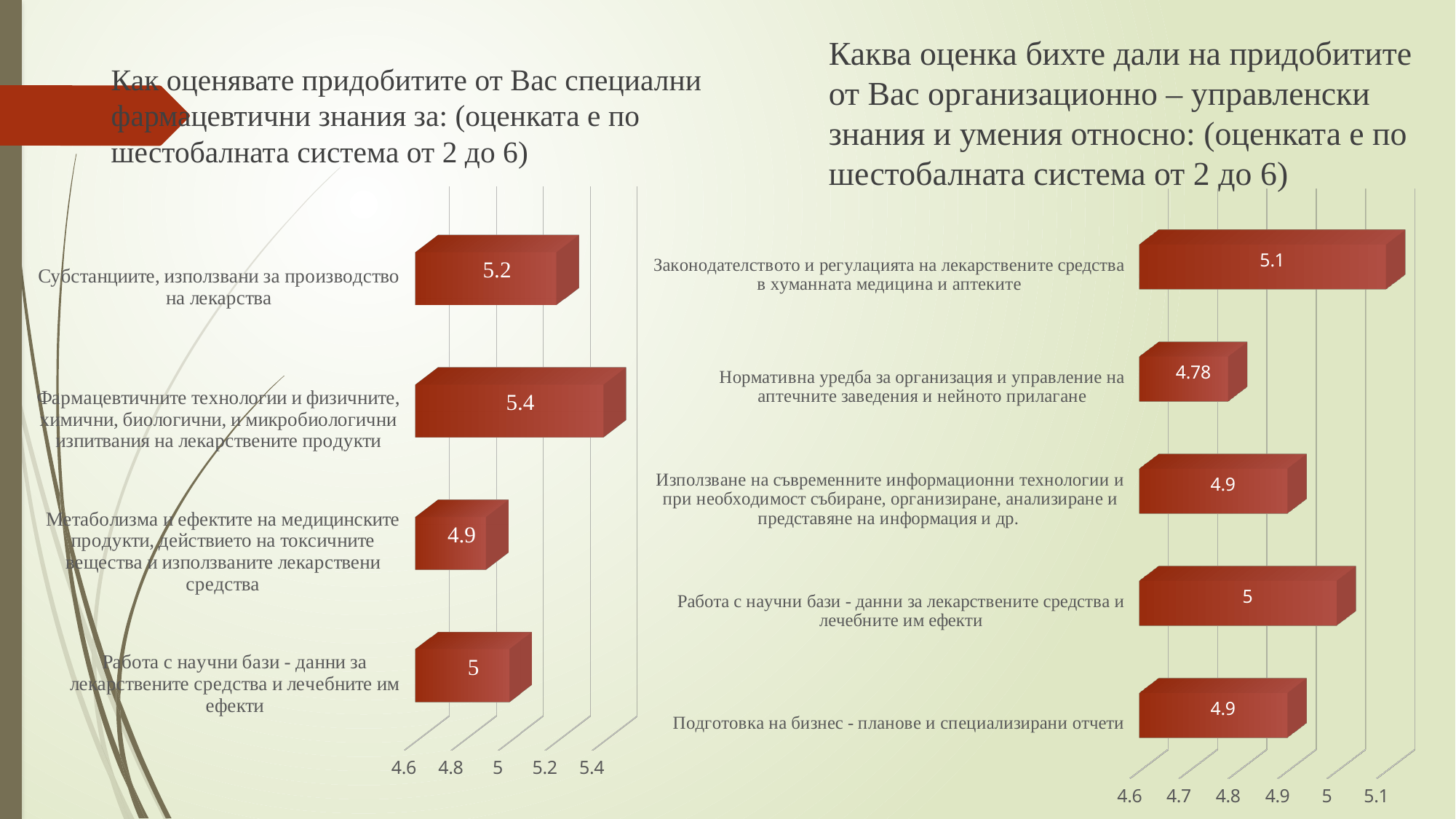
On the right chart, which category has the lowest value? Нормативна уредба за организация и управление на аптечните заведения и нейното прилагане What type of chart is the right chart? Bar chart How many categories are shown on the right chart? 5 On the left chart, which category has the lowest value? Метаболизма и ефектите на медицинските продукти, действието на токсичните вещества и използваните лекарствени средства On the right chart, what is the value for "Работа с научни бази - данни за лекарствените средства и лечебните им ефекти"? 5 On the right chart, what is the value for "Нормативна уредба за организация и управление на аптечните заведения и нейното прилагане"? 4.78 On the right chart, which category has the highest value? Законодателството и регулацията на лекарствените средства в хуманната медицина и аптеките On the left chart, what is the value for "Субстанциите, използвани за производство на лекарства"? 5.2 On the left chart, what is the difference between the values for "Фармацевтичните технологии..." (5.4) and "Работа с научни бази..." (5)? 0.4 On the right chart, which is larger: the value for "Законодателството и регулацията..." or the value for "Подготовка на бизнес - планове и специализирани отчети"? Законодателството и регулацията на лекарствените средства в хуманната медицина и аптеките How many categories are shown on the left chart? 4 On the left chart, which category has the highest value? Фармацевтичните технологии и физичните, химични, биологични, и микробиологични изпитвания на лекарствените продукти